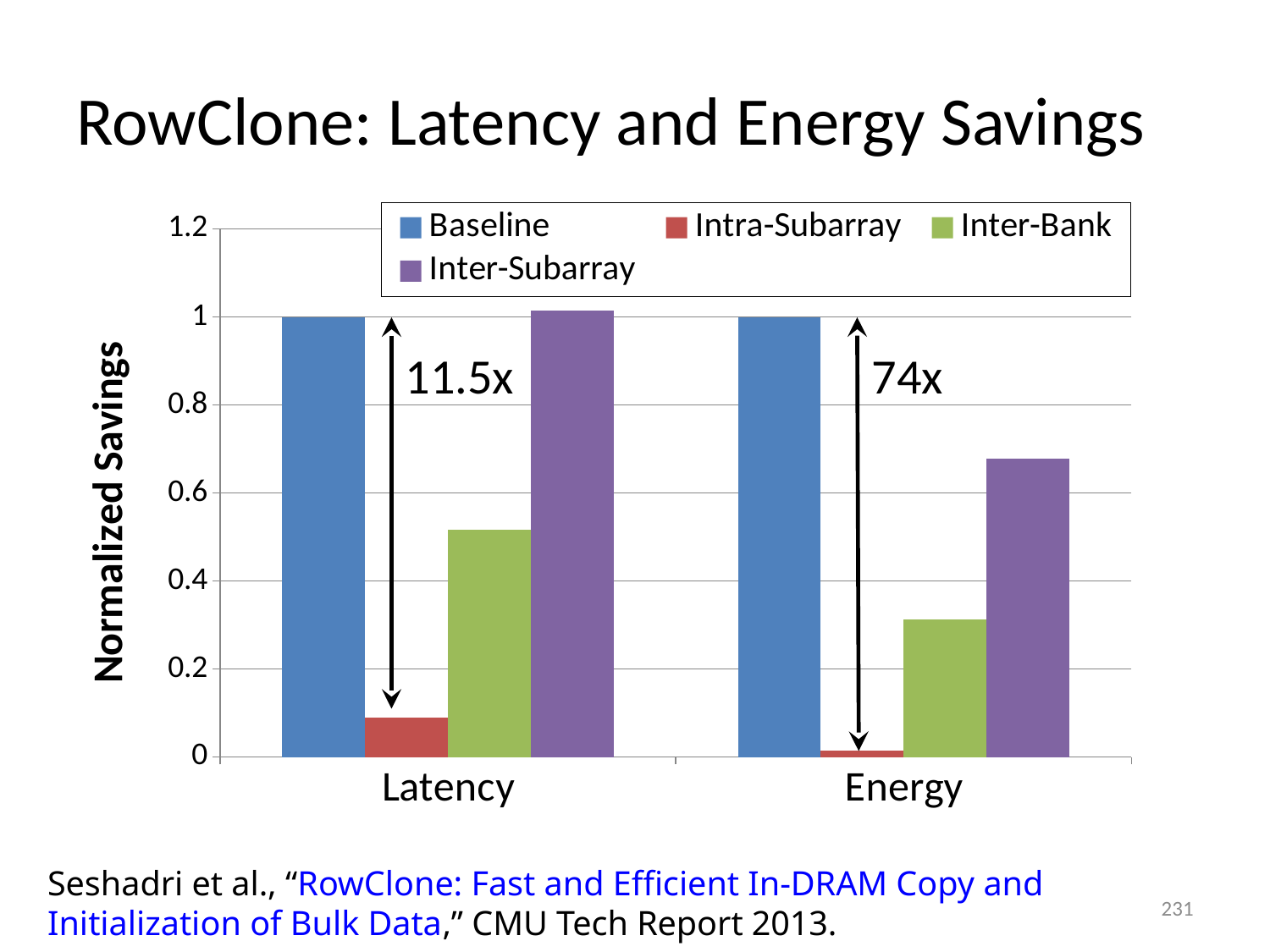
What is the Baseline value for Energy? 1 Which series has the lowest value for Energy? Intra-Subarray Is the Inter-Bank value for Energy greater or less than 0.4? less Is the Inter-Subarray value larger for Latency or for Energy? Latency How many categories are shown on the x axis? 2 How many series does the legend list? 4 Is the Inter-Bank value for Latency greater or less than 0.4? greater What is the title of the y axis? Normalized Savings What is the Baseline value for Latency? 1 What improvement factor is annotated between Baseline and Intra-Subarray for Energy? 74x What kind of chart is shown on the slide? bar chart Is the Intra-Subarray value for Latency greater or less than 0.2? less